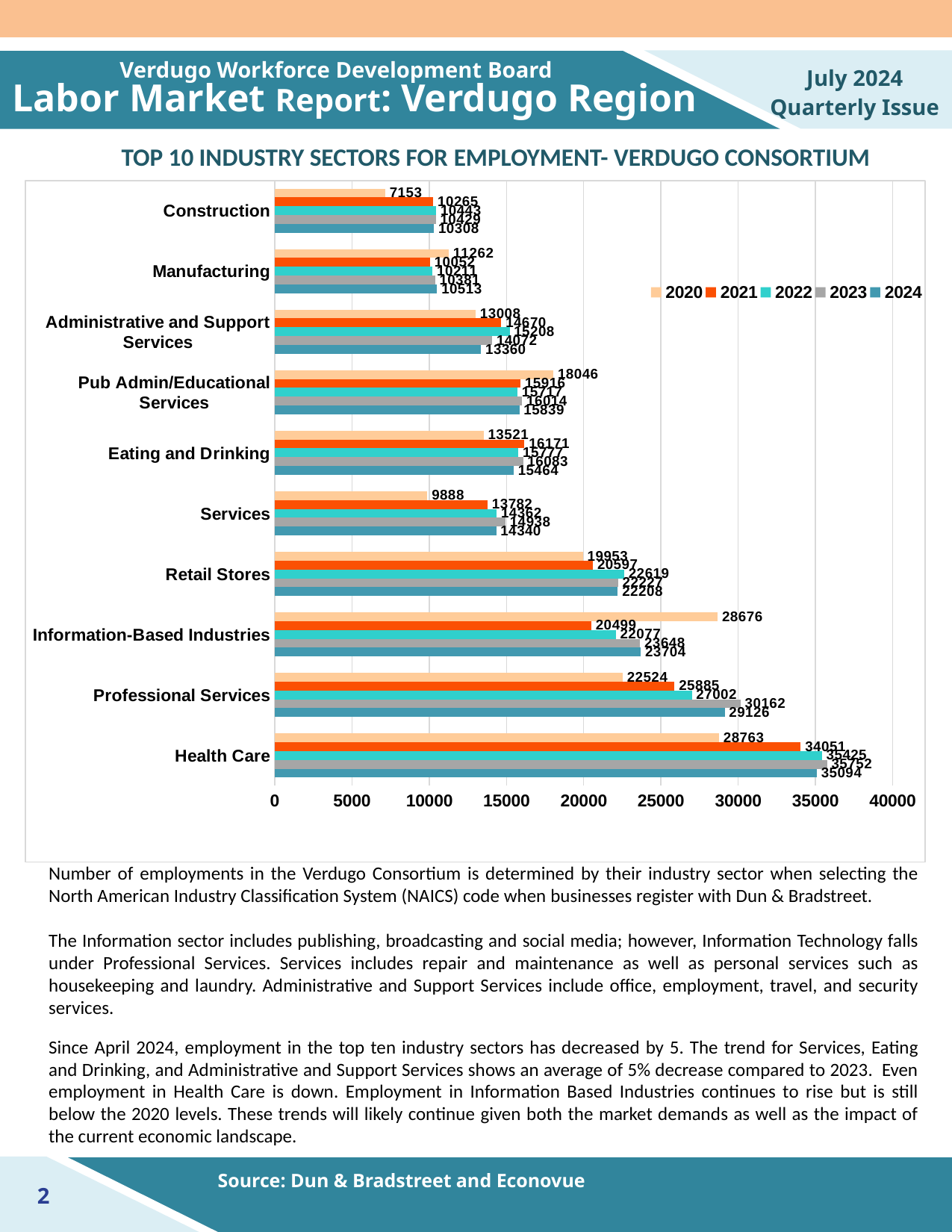
What is the difference between the 2021 and 2020 values for Health Care? 5288 Is the 2024 value for Retail Stores greater or less than 20000? greater What is the 2023 value for Professional Services? 30162 Which industry sector has the lowest 2020 value? Construction How many series does the legend list? 5 Which industry sector has the highest 2024 value? Health Care What is the 2021 value for Health Care? 34051 What kind of chart is shown on the slide? Bar chart What is the 2020 value for Information-Based Industries? 28676 What is the 2020 value for Construction? 7153 For Professional Services, which is larger: the 2023 value or the 2024 value? 2023 How many industry sectors are shown on the chart? 10